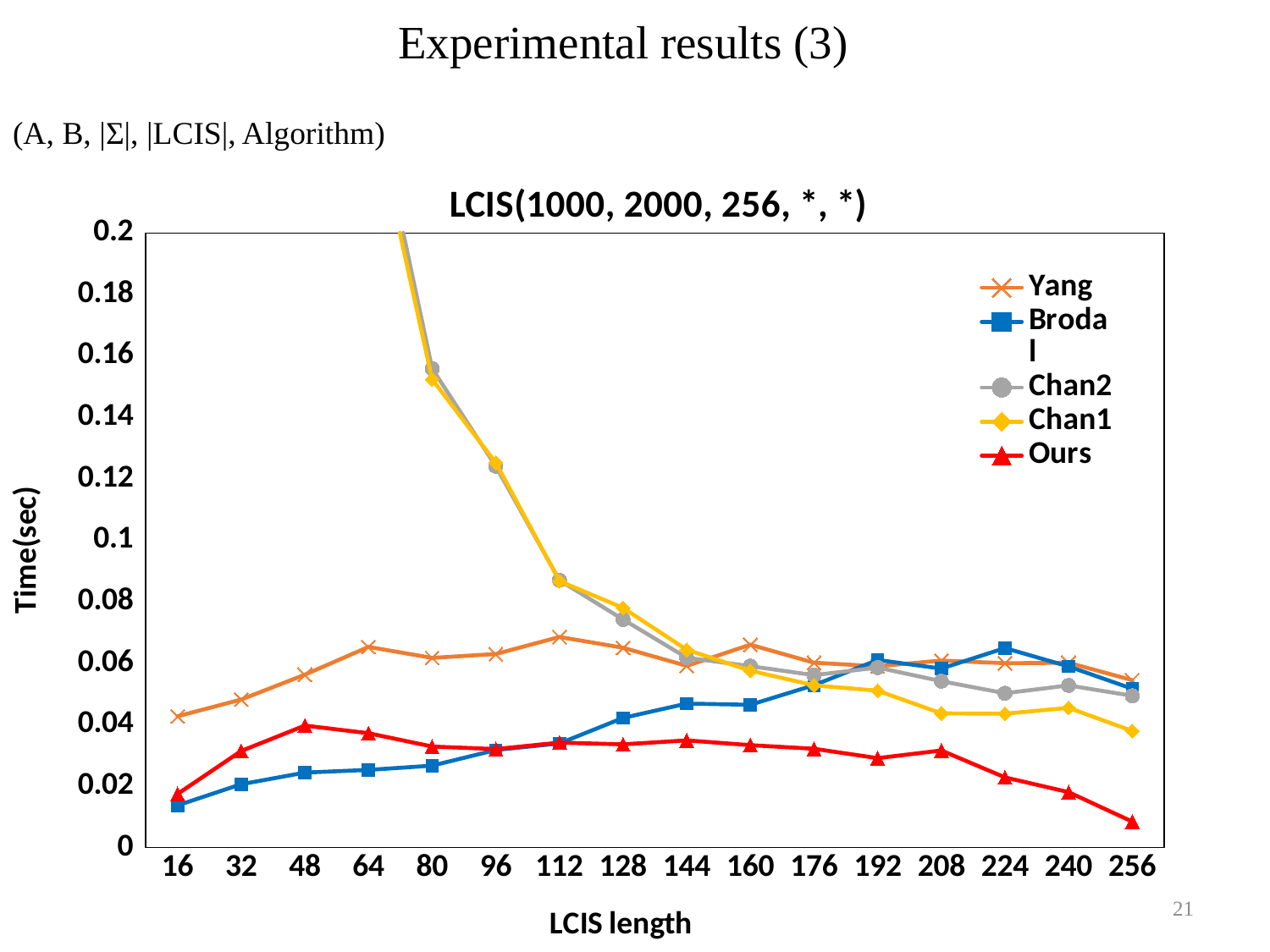
How many series does the legend list? 5 Is the value for Yang at LCIS length 16 greater or less than 0.06? less Is the value for Ours at LCIS length 256 greater or less than 0.02? less What is the title of the chart? LCIS(1000, 2000, 256, *, *) At LCIS length 80, which is larger, the value for Chan1 or the value for Ours? Chan1 What is the label of the y axis? Time(sec) Which series has the lowest value at LCIS length 256? Ours How many LCIS length values are shown on the x axis? 16 Does the Chan2 series rise or fall between LCIS length 80 and 176? fall Is the value for Chan1 at LCIS length 208 greater or less than 0.06? less What kind of chart is shown on the slide? line chart